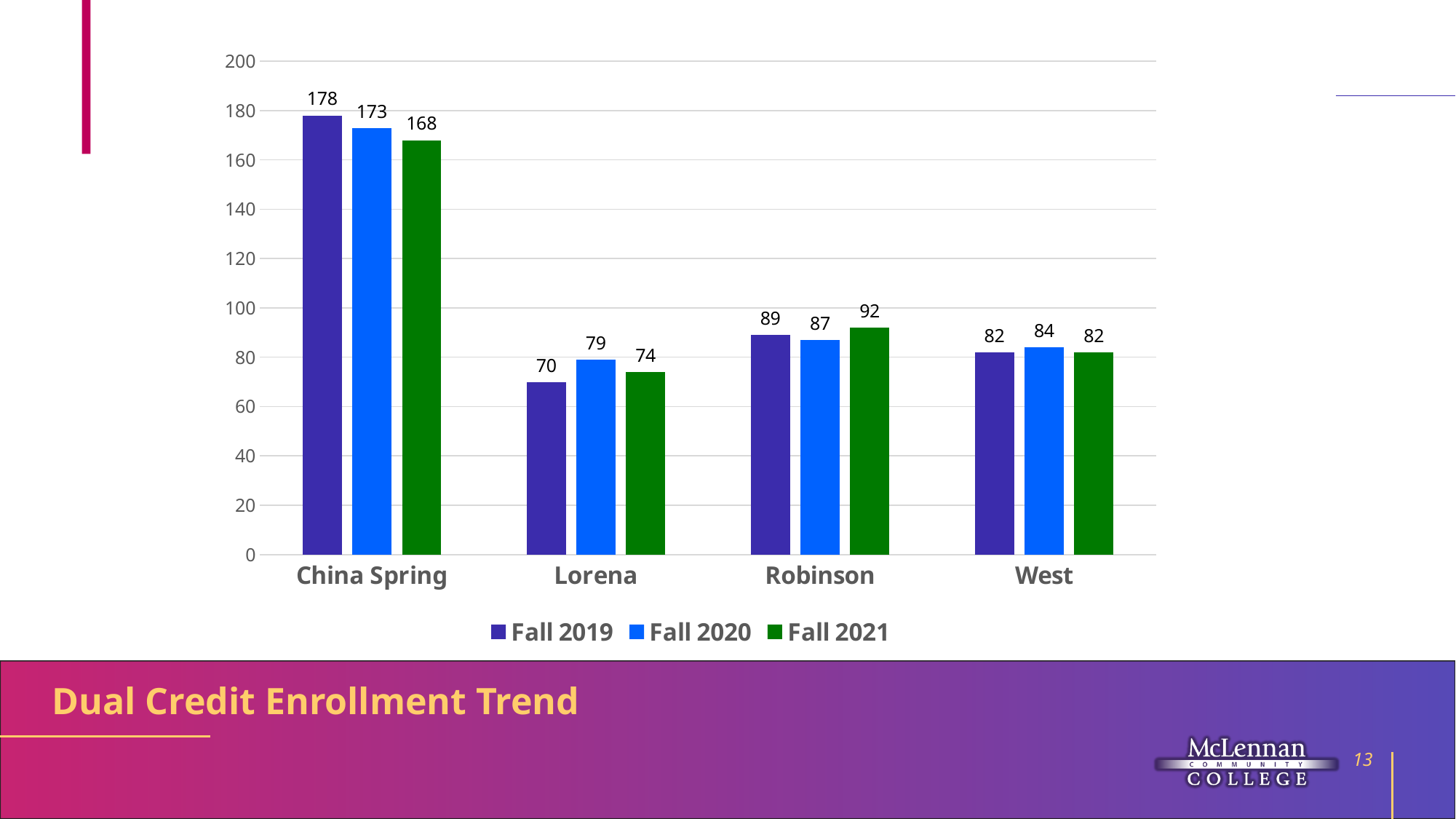
Which school has the highest Fall 2021 value? China Spring What is the difference between the Fall 2019 and Fall 2021 values for China Spring? 10 What is the Fall 2021 value for Robinson? 92 What is the Fall 2020 value for Lorena? 79 What is the Fall 2019 value for China Spring? 178 How many series does the legend list? 3 Which school has the lowest Fall 2019 value? Lorena What kind of chart is shown on the slide? bar chart Which is larger for Robinson: the Fall 2019 value or the Fall 2021 value? Fall 2021 Is the Fall 2020 value for West greater or less than 100? less Do the values for China Spring rise or fall from Fall 2019 to Fall 2021? fall How many schools are shown on the x axis? 4